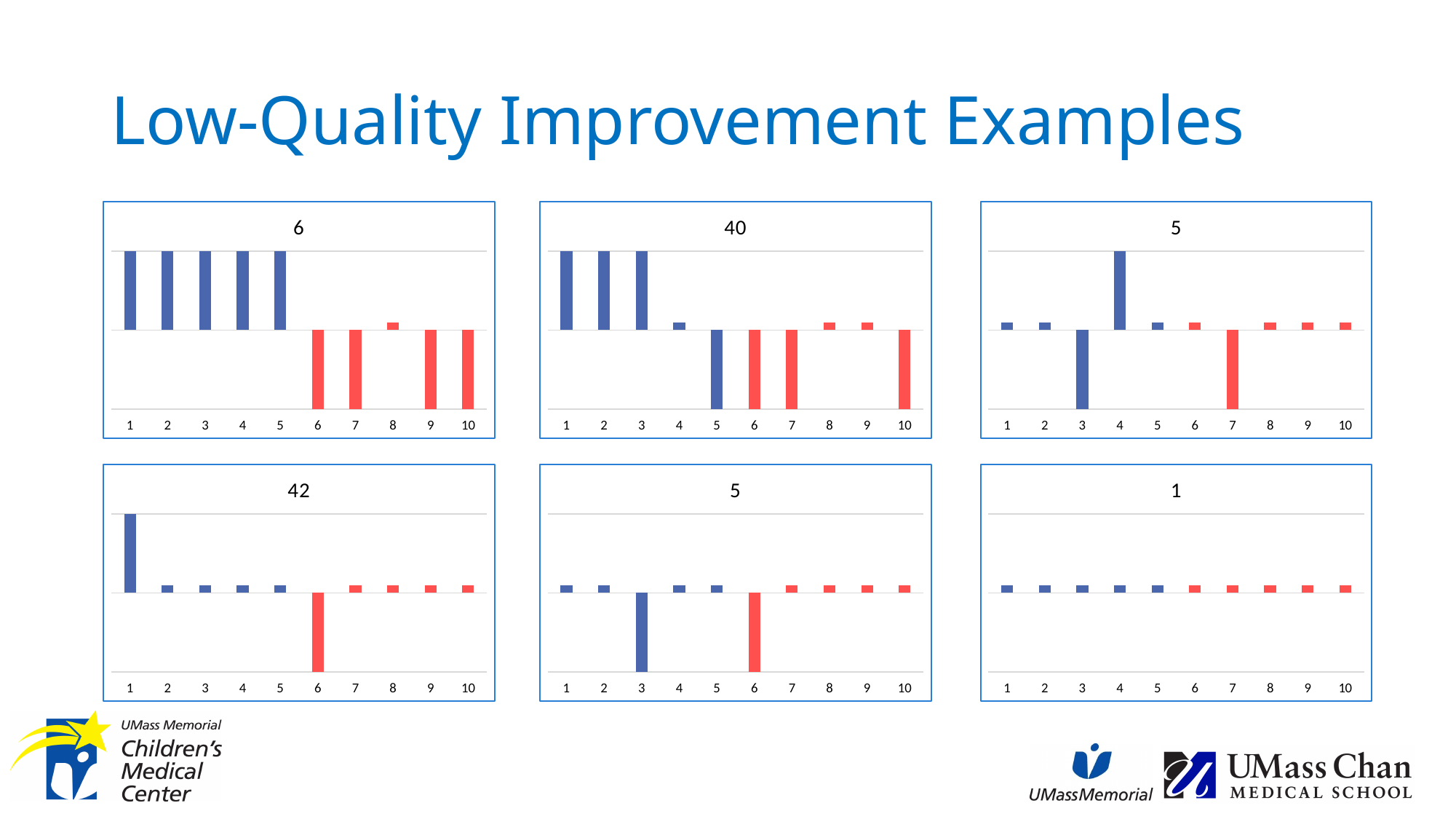
What is the title of the top-middle chart? 40 In the chart titled "6", which is larger, the value for category 3 or the value for category 9? category 3 In the chart titled "6", what colour are the bars for categories 6 to 10? red In the chart titled "42", which category has the lowest bar? 6 How many categories are on the x axis of the chart titled "42"? 10 In the chart titled "42", which is larger, the value for category 1 or the value for category 6? category 1 In the top-right chart titled "5", which category has the highest bar? 4 What is the title of the bottom-right chart? 1 In the chart titled "42", which category has the highest bar? 1 How many charts are shown on the slide? 6 In the chart titled "40", which is larger, the value for category 1 or the value for category 5? category 1 What kind of chart is the top-left chart titled "6"? bar chart